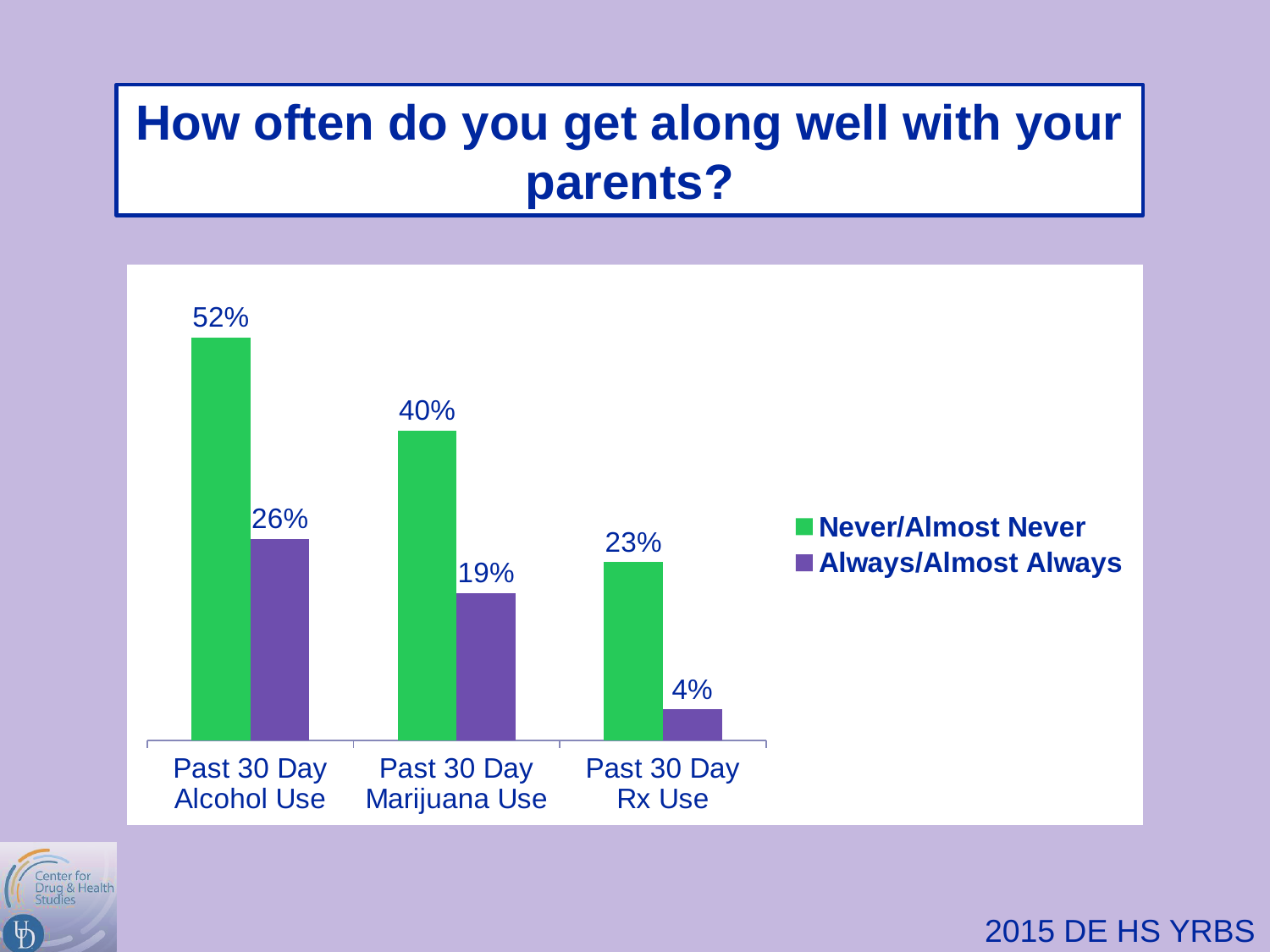
How many series does the legend list? 2 Which category has the highest Never/Almost Never value? Past 30 Day Alcohol Use What is the value for Always/Almost Always for Past 30 Day Rx Use? 4% How many categories are shown on the x axis? 3 Which is larger: the Always/Almost Always value for Past 30 Day Alcohol Use or the Never/Almost Never value for Past 30 Day Rx Use? Always/Almost Always for Past 30 Day Alcohol Use What is the difference between the Never/Almost Never values for Past 30 Day Marijuana Use and Past 30 Day Rx Use? 17% Which category has the lowest Always/Almost Always value? Past 30 Day Rx Use What is the value for Never/Almost Never for Past 30 Day Rx Use? 23% What kind of chart is shown on the slide? Bar chart What is the value for Never/Almost Never for Past 30 Day Alcohol Use? 52% What is the value for Always/Almost Always for Past 30 Day Marijuana Use? 19% What is the difference between the Never/Almost Never and Always/Almost Always values for Past 30 Day Alcohol Use? 26%